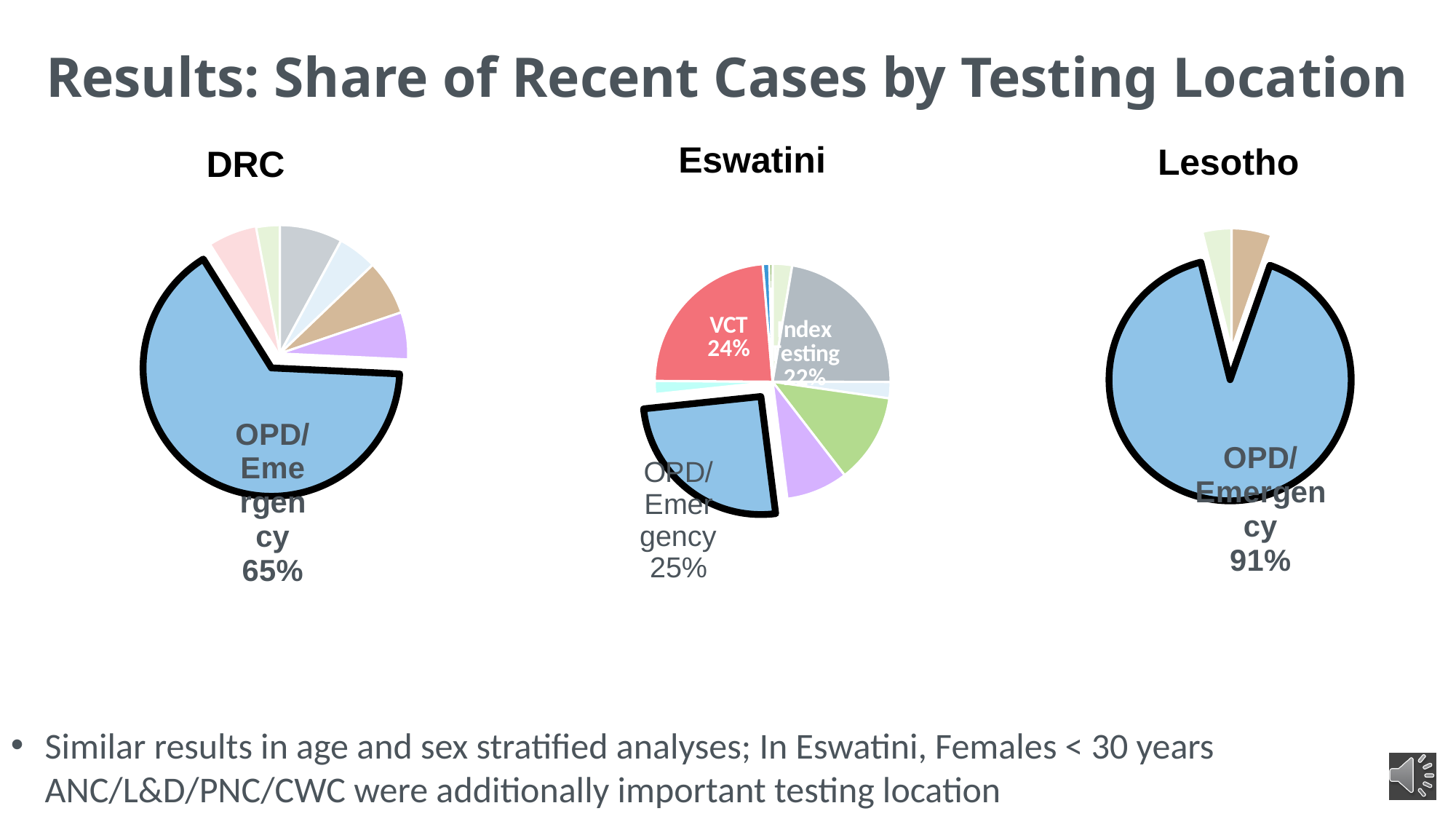
In the Eswatini chart, what share of recent cases were tested at VCT? 24% In the Eswatini chart, what share of recent cases were tested through Index Testing? 22% In the Eswatini chart, what is the difference in percentage points between the VCT share and the Index Testing share? 2 percentage points Which country's chart shows the larger OPD/Emergency share, DRC or Lesotho? Lesotho In the Eswatini chart, which labelled testing location has the largest share? OPD/Emergency In the DRC chart, what share of recent cases were tested at OPD/Emergency? 65% In the Eswatini chart, what share of recent cases were tested at OPD/Emergency? 25% In the Lesotho chart, what share of recent cases were tested at OPD/Emergency? 91% What kind of chart is used for each country on this slide? Pie chart In the Eswatini chart, which is larger, the VCT share or the Index Testing share? VCT What is the difference in percentage points between the OPD/Emergency share in Lesotho and in DRC? 26 percentage points How many pie charts are shown on the slide? 3